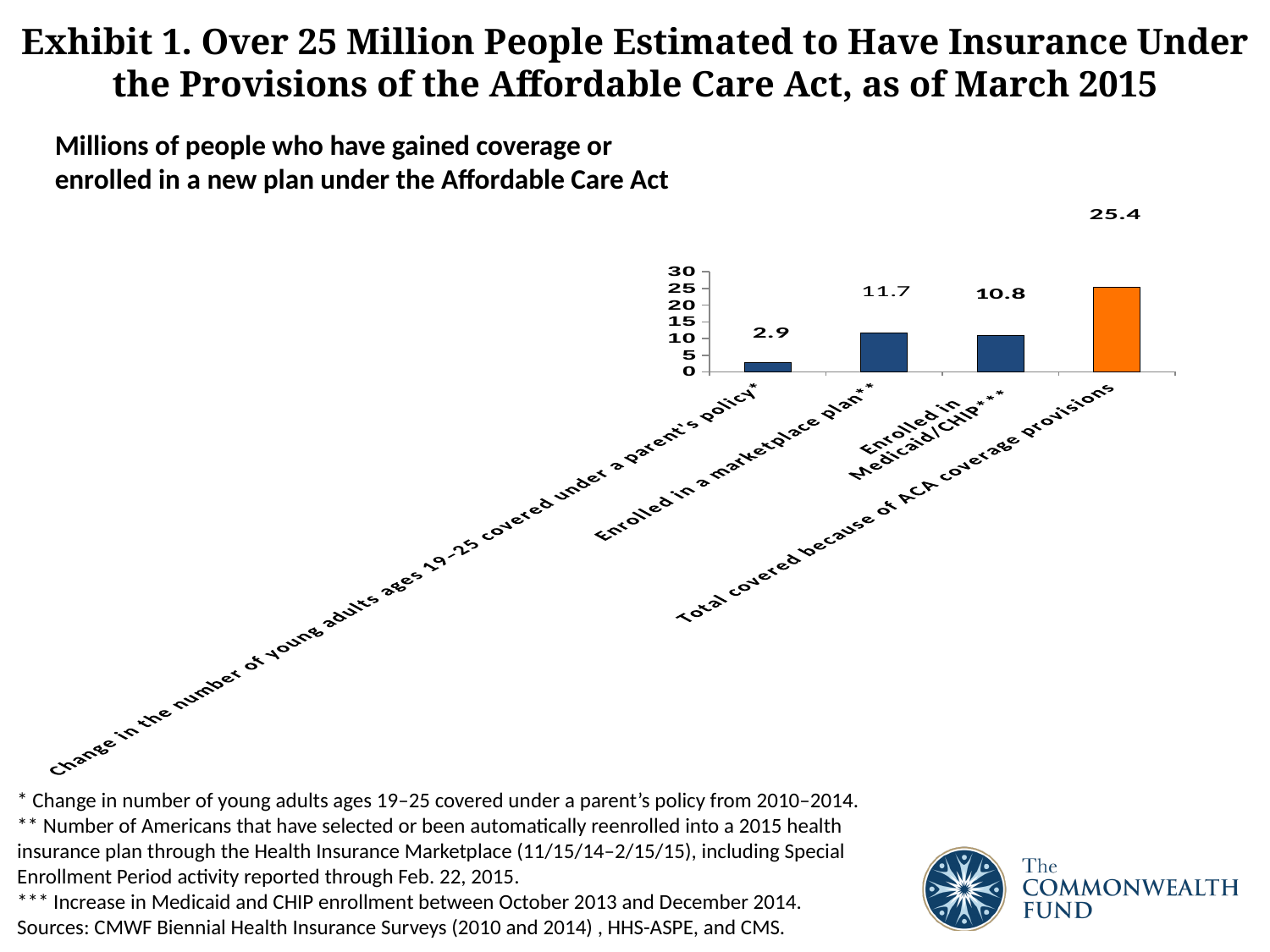
Which category has the highest value? Total covered because of ACA coverage provisions What is the value for 'Enrolled in Medicaid/CHIP***'? 10.8 What is the value for 'Enrolled in a marketplace plan**'? 11.7 Is the value for 'Total covered because of ACA coverage provisions' greater or less than 20? greater Which category has the lowest value? Change in the number of young adults ages 19-25 covered under a parent's policy* Which is larger: the value for 'Enrolled in a marketplace plan**' or the value for 'Change in the number of young adults ages 19-25 covered under a parent's policy*'? Enrolled in a marketplace plan** What is the value for 'Change in the number of young adults ages 19-25 covered under a parent's policy*'? 2.9 What is the value for 'Total covered because of ACA coverage provisions'? 25.4 What is the difference between the value for 'Enrolled in a marketplace plan**' and the value for 'Enrolled in Medicaid/CHIP***'? 0.9 Which bar is coloured orange rather than dark blue? Total covered because of ACA coverage provisions How many categories are shown on the x axis? 4 What kind of chart is shown on the slide? bar chart